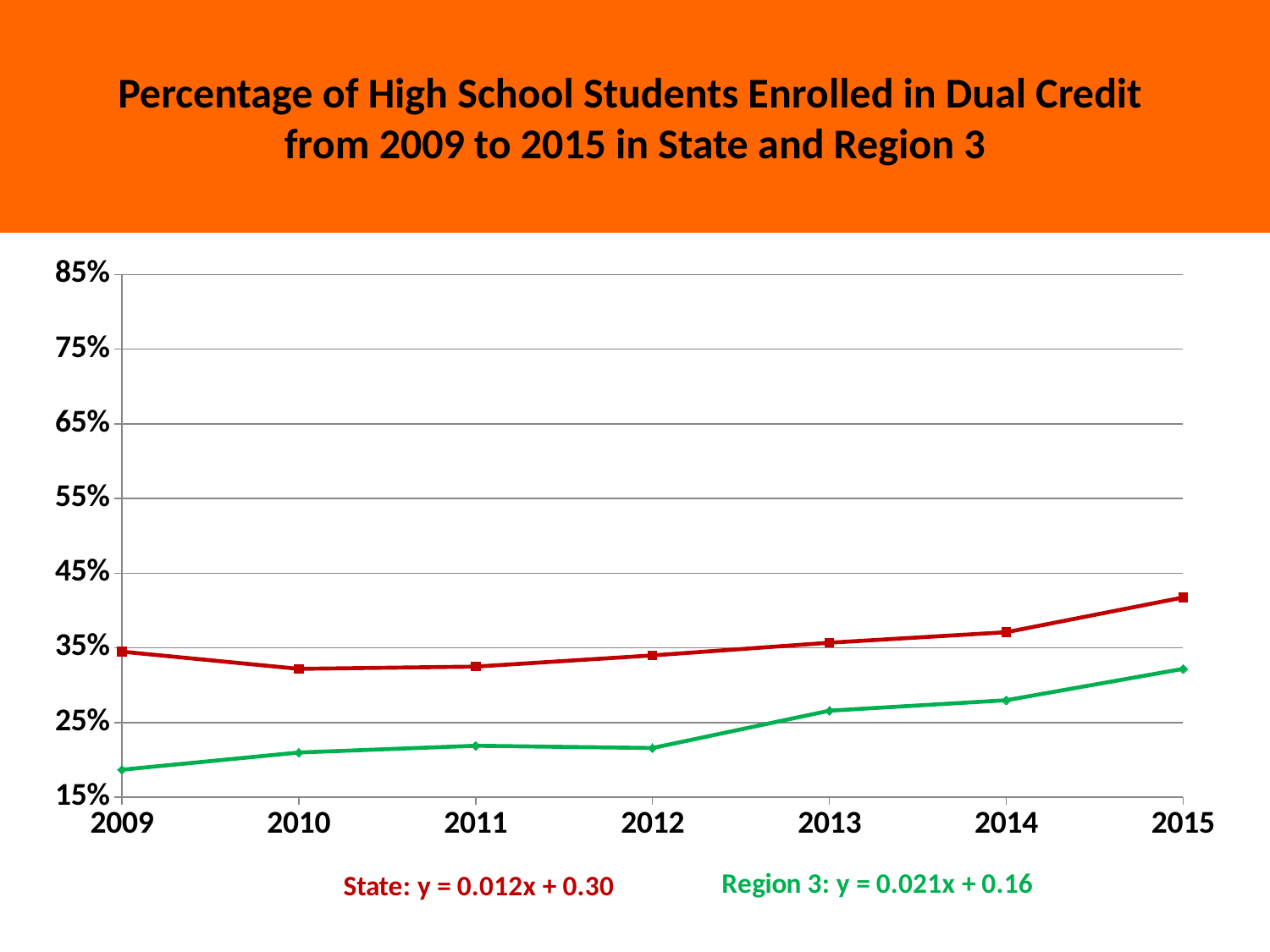
Is the value for State in 2010 greater or less than 35%? less In 2015, which series has the larger value, State or Region 3? State Is the value for Region 3 in 2009 greater or less than 25%? less What colour is the line for the State series? red How many years are plotted along the x axis? 7 Does the Region 3 series generally rise or fall from 2009 to 2015? rise In which year is the Region 3 series at its highest? 2015 Is the value for Region 3 in 2015 greater or less than 25%? greater In which year is the State series at its highest? 2015 How many series are plotted on the chart? 2 What kind of chart is shown on the slide? line chart In which year is the Region 3 series at its lowest? 2009